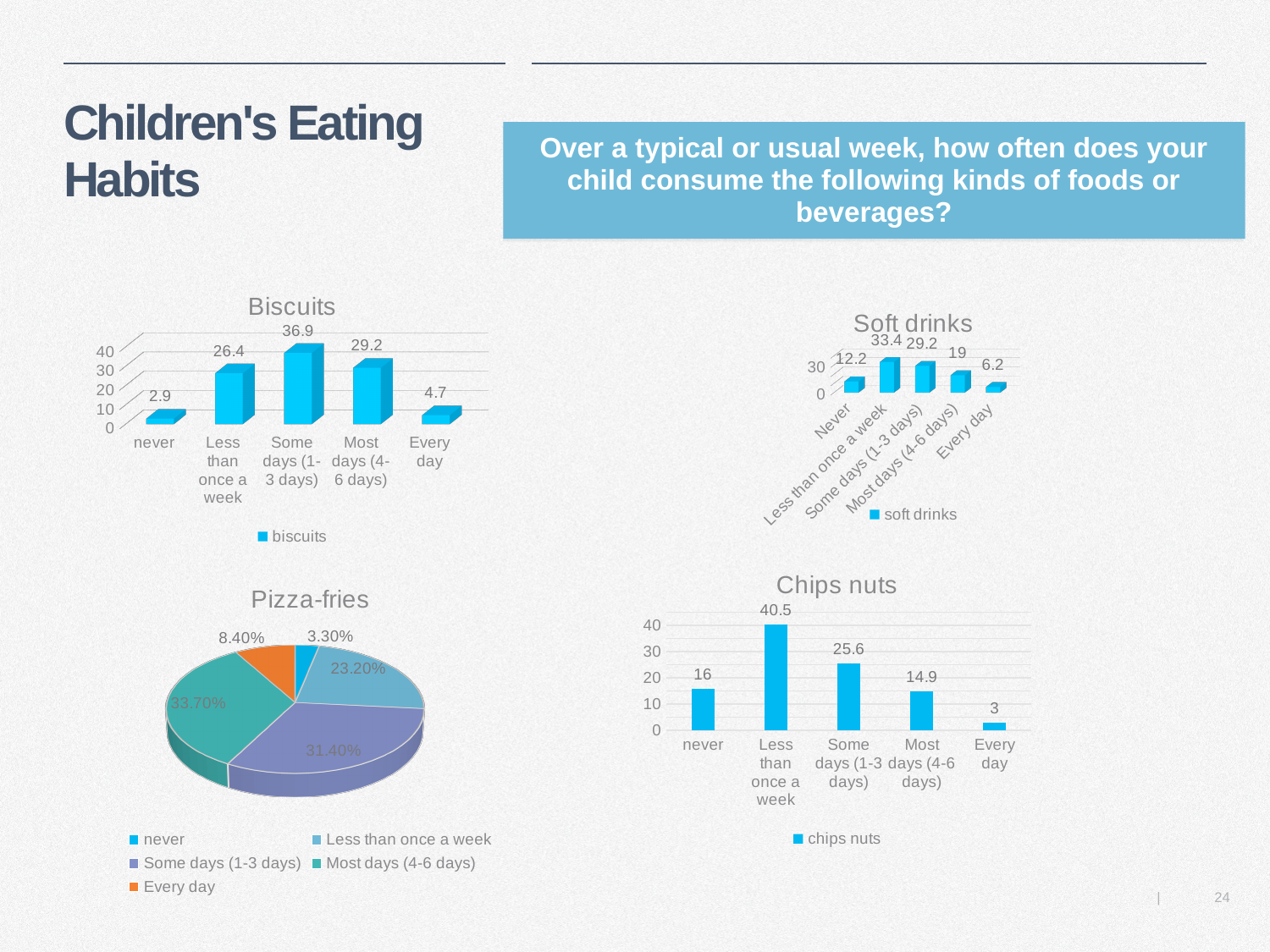
In the Biscuits chart, what is the value for Some days (1-3 days)? 36.9 In the Soft drinks chart, which is larger, the value for Never or the value for Most days (4-6 days)? Most days (4-6 days) In the Chips nuts chart, how many categories are shown on the x axis? 5 In the Soft drinks chart, what is the value for Less than once a week? 33.4 In the Chips nuts chart, what is the value for Less than once a week? 40.5 In the Biscuits chart, which category has the lowest value? never In the Chips nuts chart, what is the difference between the values for never and Every day? 13 In the Pizza-fries chart, what share does Most days (4-6 days) have? 33.70% In the Biscuits chart, what is the difference between the values for Most days (4-6 days) and Every day? 24.5 In the Pizza-fries chart, what percentage is shown for Every day? 8.40% What kind of chart is the Pizza-fries chart? pie chart In the Soft drinks chart, which category has the highest value? Less than once a week